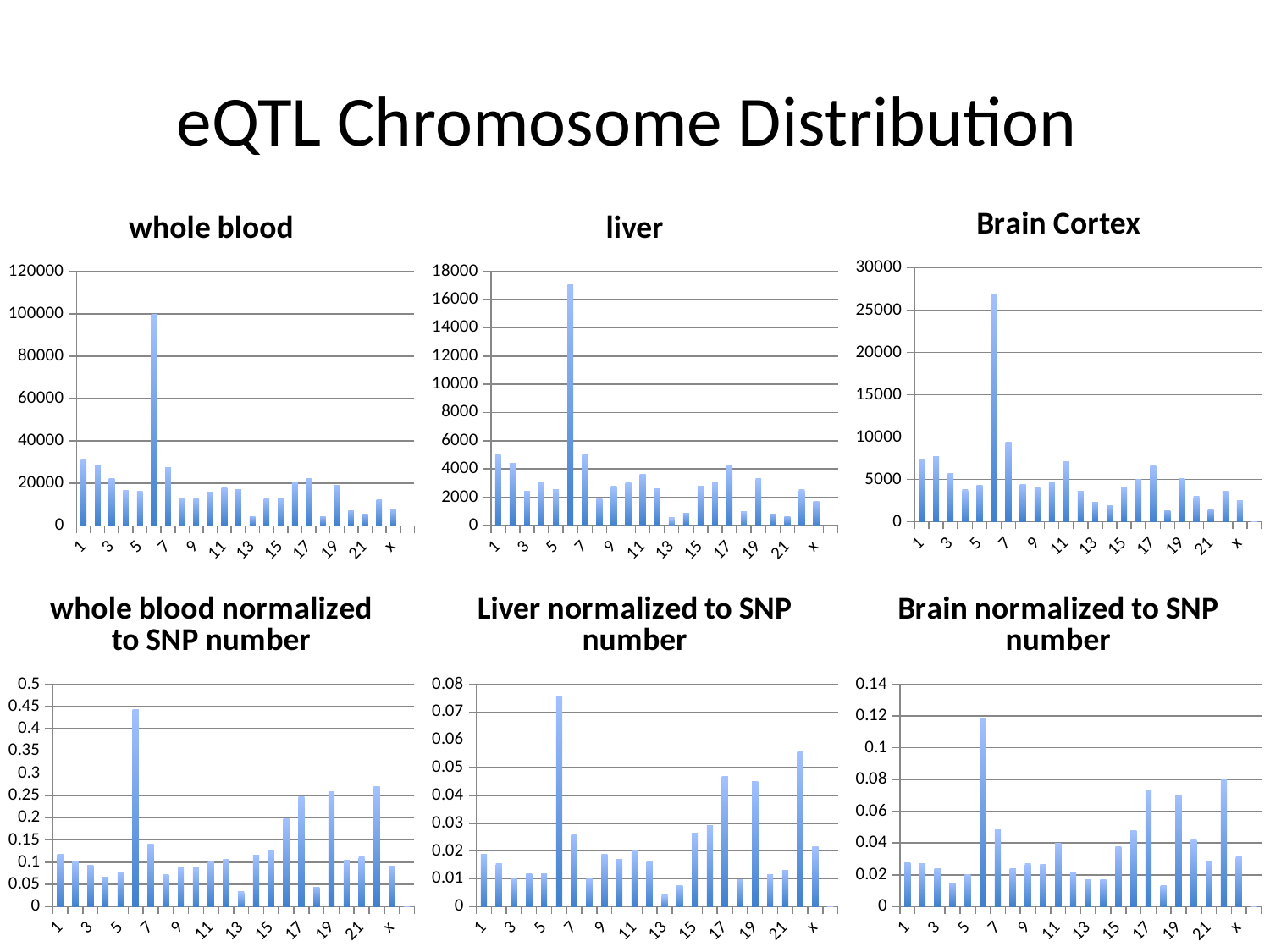
In the "Liver normalized to SNP number" chart, is the value for chromosome 17 greater or less than 0.04? greater In the "whole blood" chart, is the value for chromosome 13 greater or less than 20000? less In the "Brain normalized to SNP number" chart, is the value for chromosome 17 greater or less than 0.06? greater How many charts are shown on the slide? 6 In the "whole blood" chart, which has the larger value, chromosome 1 or chromosome 13? chromosome 1 In the "liver" chart, how many categories are plotted along the x axis? 23 What type of chart is the "whole blood" chart? bar chart